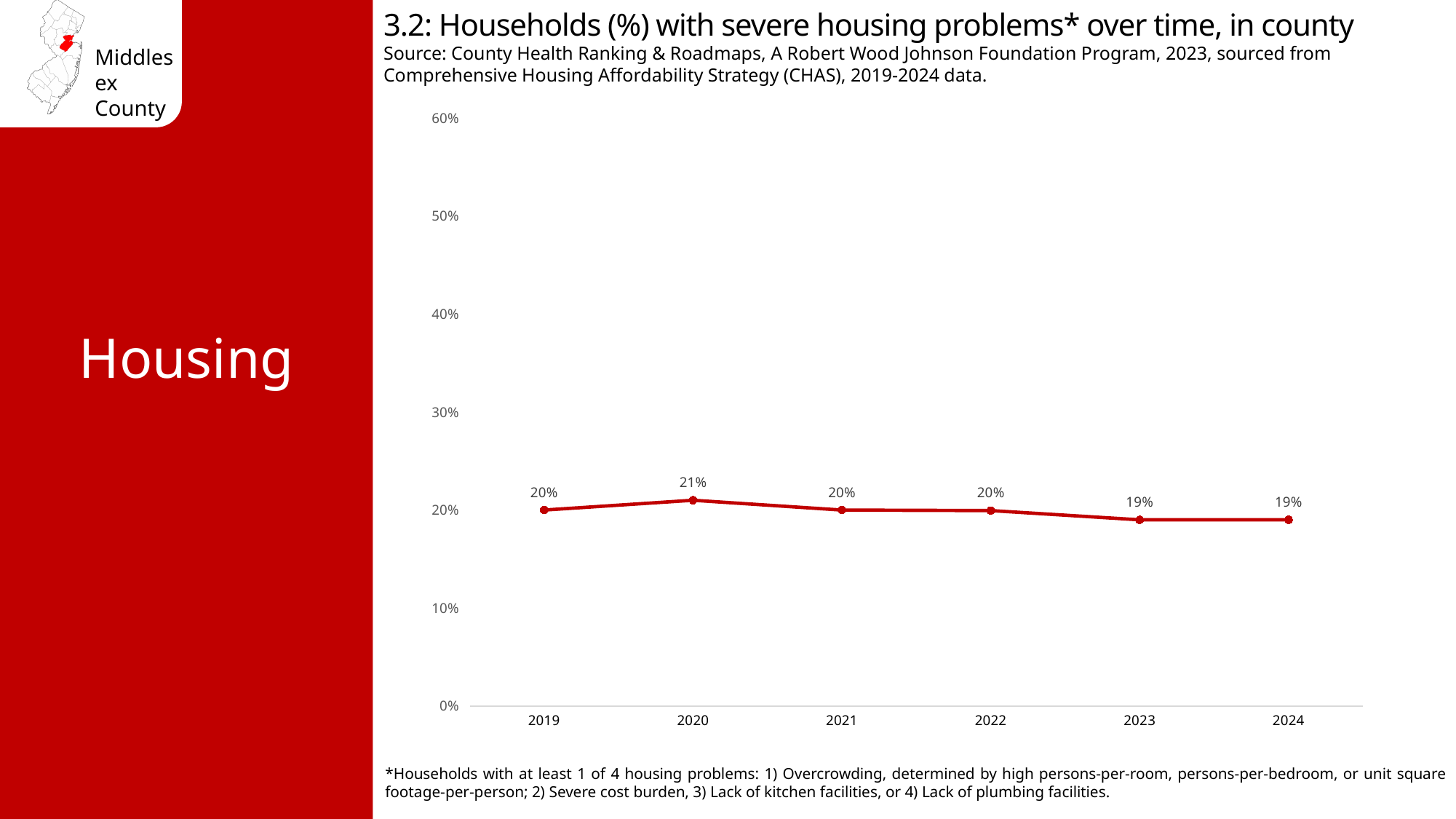
What kind of chart is shown on the slide? line chart What is the highest value shown on the vertical axis? 60% What is the difference between the 2020 value and the 2023 value? 2% What percentage of households had severe housing problems in 2020? 21% What is the title of the chart? 3.2: Households (%) with severe housing problems* over time, in county What is the value shown for 2019? 20% Does the value rise or fall from 2022 to 2023? fall Which year has the highest percentage of households with severe housing problems? 2020 How many years are plotted on the chart? 6 Is the value for 2022 greater or less than 30%? less What is the value shown for 2024? 19% Is the value for 2021 larger or smaller than the value for 2020? smaller